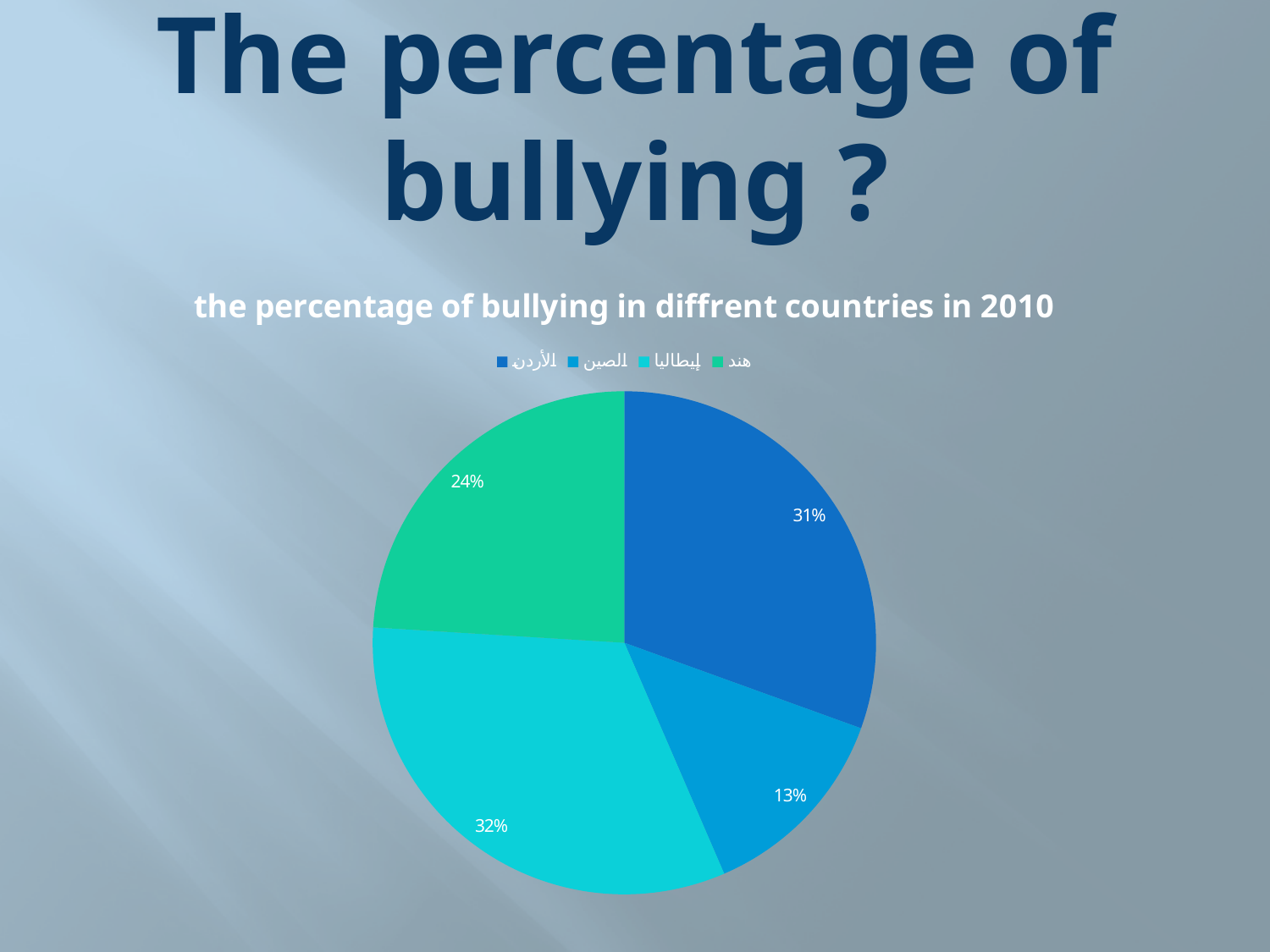
What percentage is shown for الصين? 13% What percentage is shown for إيطاليا? 32% What percentage is shown for هند? 24% How many slices does the pie chart have? 4 What is the title of the chart? the percentage of bullying in diffrent countries in 2010 What kind of chart is shown on the slide? pie chart Which country has the smallest slice of the pie? الصين How many entries does the legend list? 4 What is the difference between the percentages for هند and الصين? 11% Which is larger, the slice for الأردن or the slice for هند? الأردن What percentage is shown for الأردن? 31% Which country has the largest slice of the pie? إيطاليا